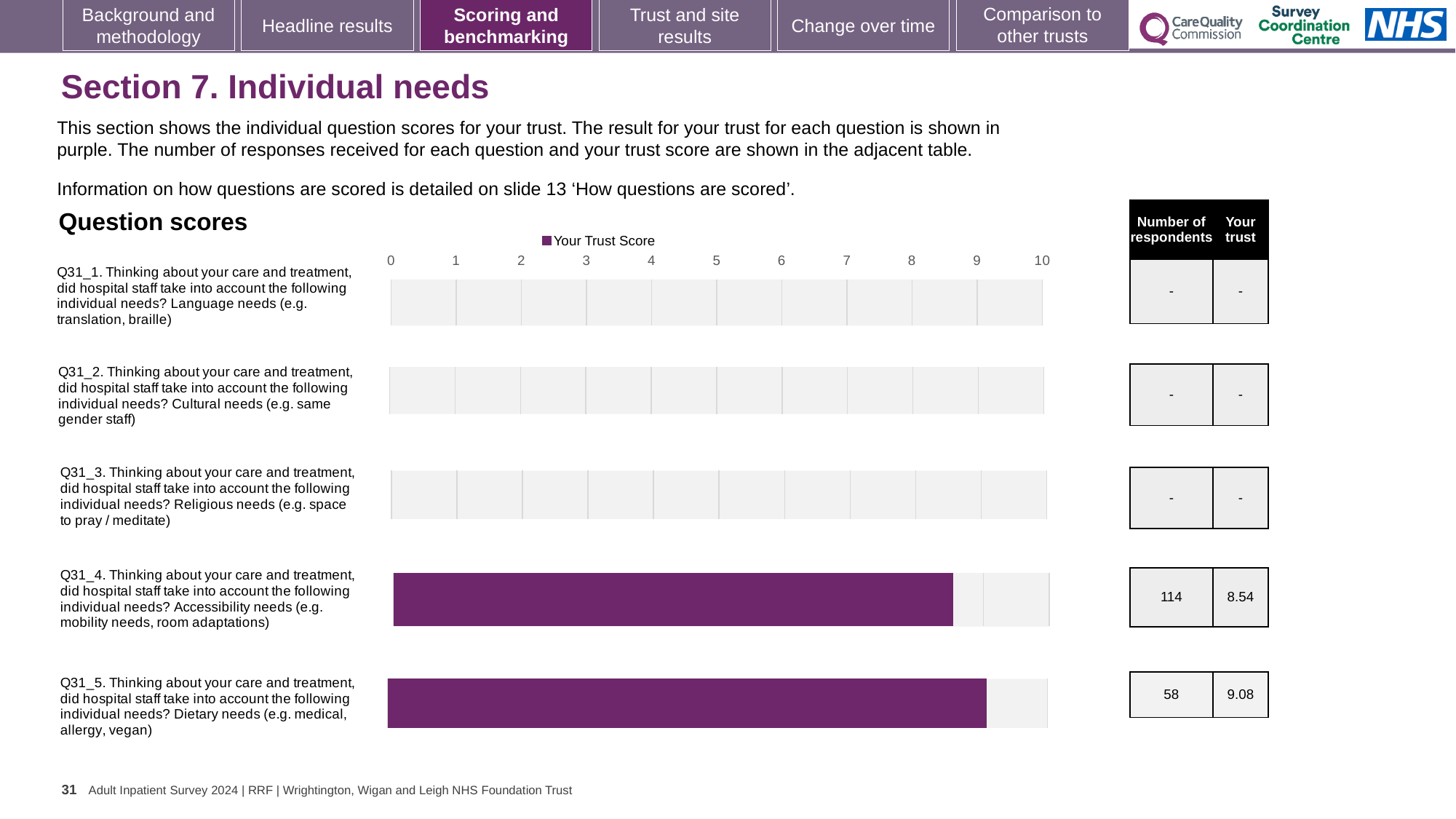
What is the difference between the trust scores for Q31_5 (Dietary needs) and Q31_4 (Accessibility needs)? 0.54 Which question has the higher trust score, Q31_4 (Accessibility needs) or Q31_5 (Dietary needs)? Q31_5 (Dietary needs) How many respondents answered Q31_5 (Dietary needs)? 58 How many series does the legend of the Question scores chart list? 1 How many questions are listed in the Question scores chart? 5 How many respondents answered Q31_4 (Accessibility needs)? 114 Is the trust score for Q31_5 (Dietary needs) greater or less than 10? less Is the trust score for Q31_4 (Accessibility needs) greater or less than 8? greater What is the maximum value shown on the x axis of the Question scores chart? 10 What is the trust score for Q31_5 (Dietary needs)? 9.08 What kind of chart is used to show the question scores? Bar chart What is the trust score for Q31_4 (Accessibility needs)? 8.54